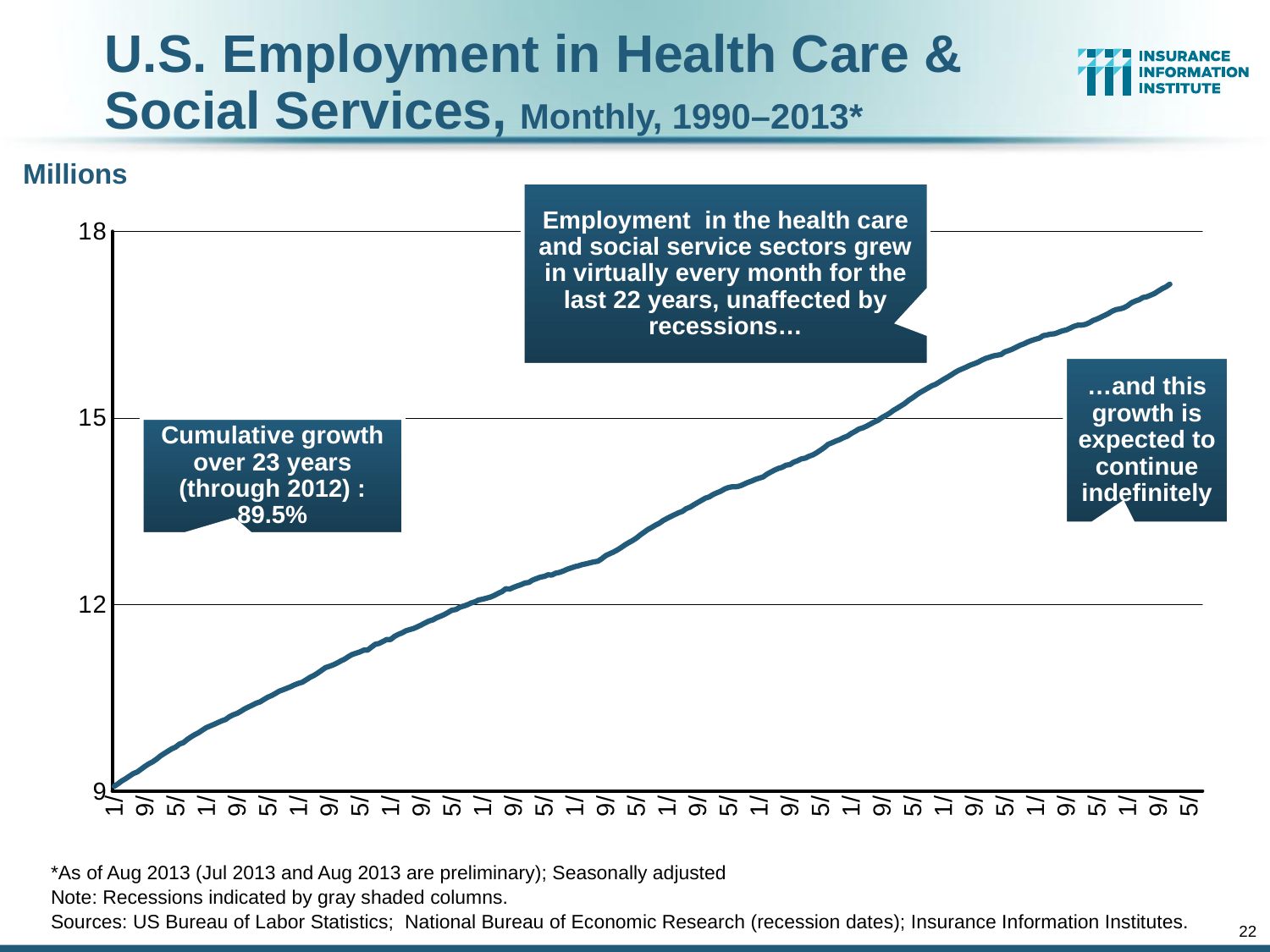
What kind of chart is shown on the slide? line chart Is the value at the left end of the line (the start of 1990) greater or less than 12? less Is the value at the right end of the line (the most recent month) greater or less than 15? greater According to the callout on the chart, what was the cumulative growth over 23 years (through 2012)? 89.5% What is the highest value shown on the y axis? 18 What unit label is shown above the y axis? Millions Do the values on the chart generally rise or fall from left to right along the x axis? rise Is the value at the right end of the line (the most recent month) greater or less than 18? less